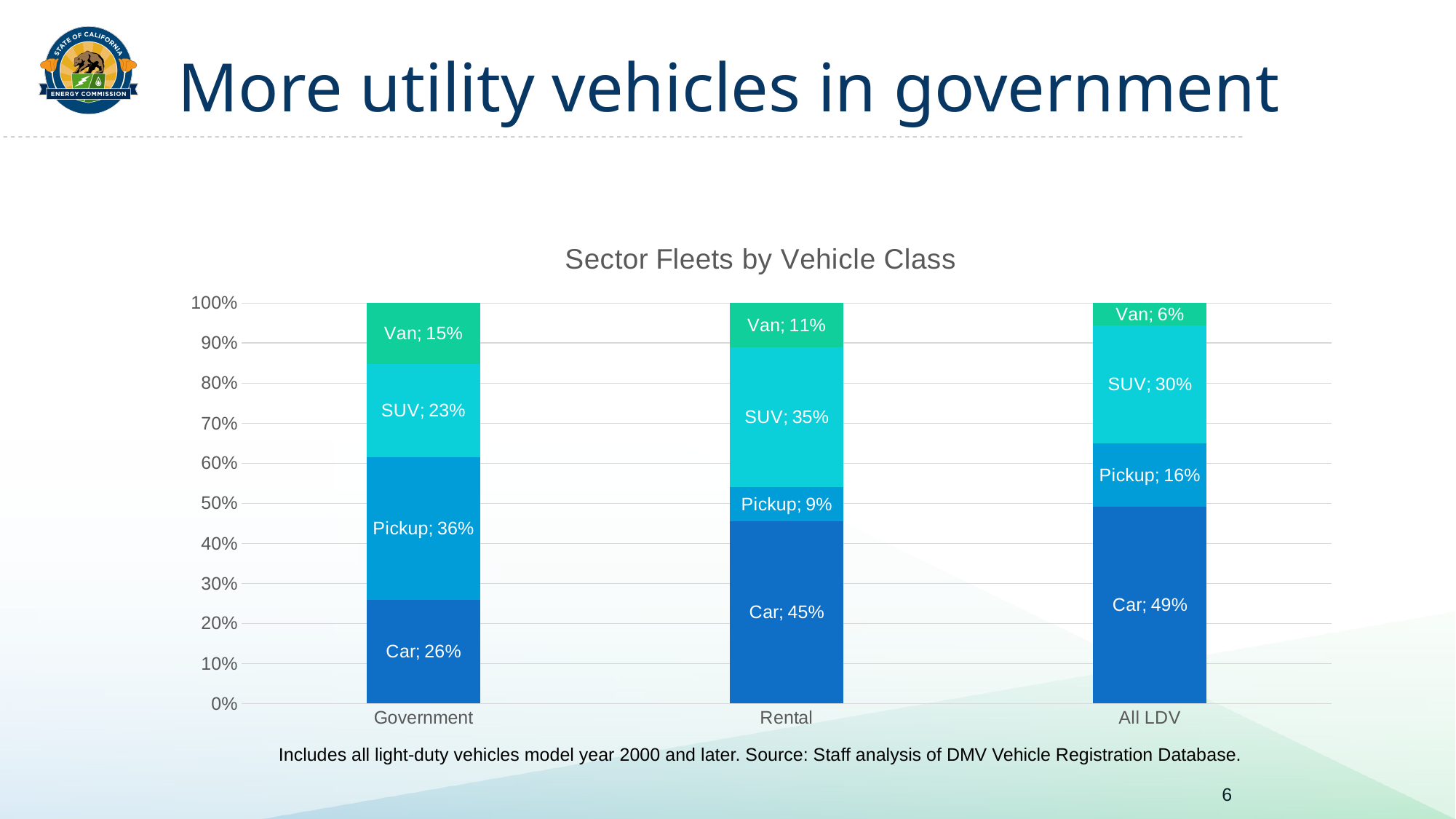
How many vehicle classes make up each stacked bar? 4 How much larger is the Pickup share in Government than in All LDV? 20% What share of the Rental fleet is Car? 45% How many sectors are shown on the x axis? 3 What share of the Rental fleet is SUV? 35% What share of the All LDV fleet is Van? 6% What type of chart is shown? Stacked bar chart What share of the Government fleet is Pickup? 36% What is the title of the chart? Sector Fleets by Vehicle Class Which sector has the lowest Pickup share? Rental Which is larger: the Van share for Government or for Rental? Government Which sector has the highest Car share? All LDV